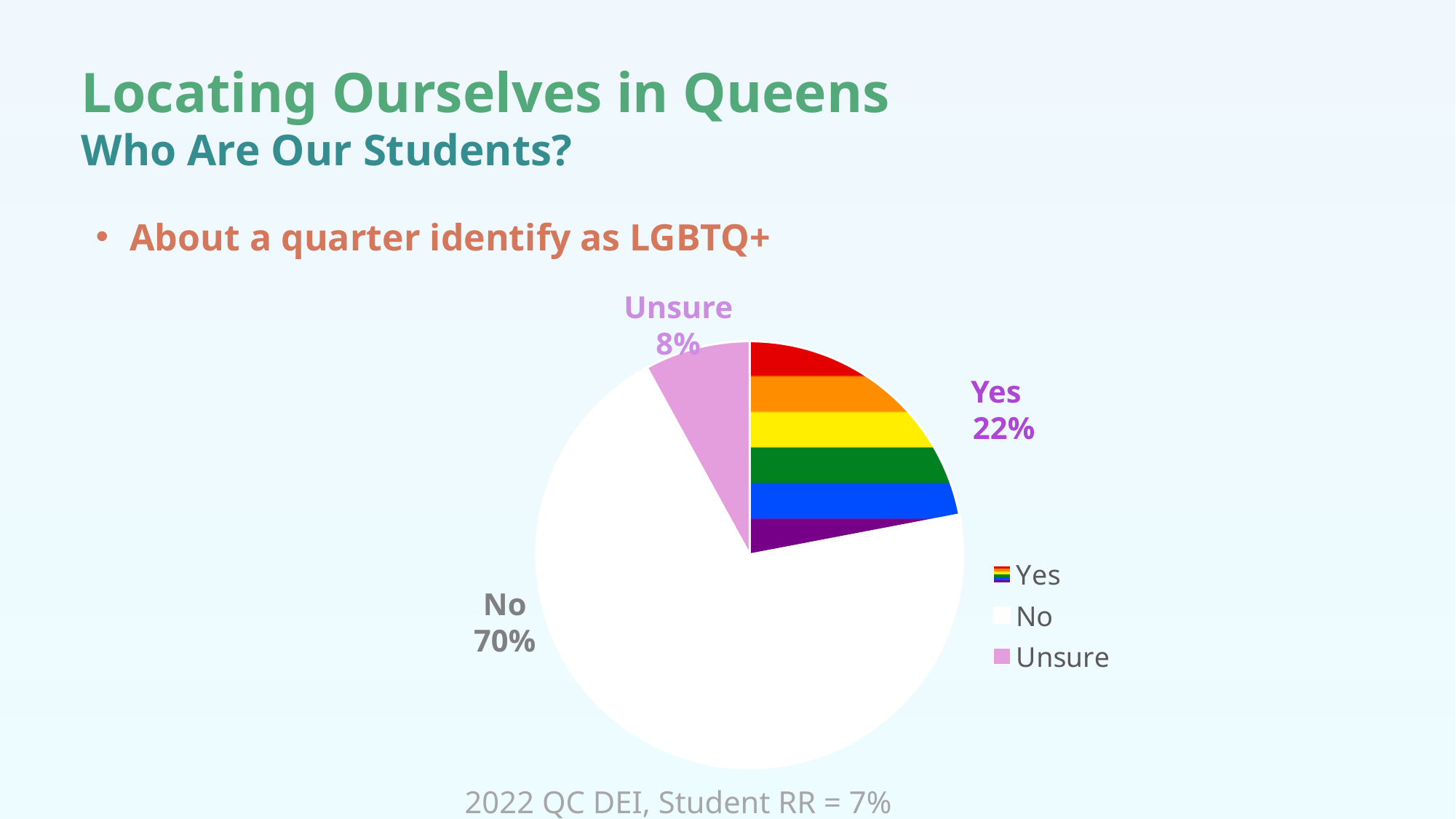
What kind of chart is shown on the slide? pie chart What percentage of students answered Yes to identifying as LGBTQ+? 22% What percentage of students answered Unsure? 8% Which is larger, the Yes slice or the Unsure slice? Yes Which response has the smallest share of the pie? Unsure How many slices does the pie chart have? 3 What is the combined share of the Yes and Unsure slices? 30% Which slice of the pie is filled with rainbow stripes? Yes What percentage of students answered No? 70% How many entries does the legend list? 3 Which response has the largest share of the pie? No What is the difference in percentage points between the No and Yes slices? 48